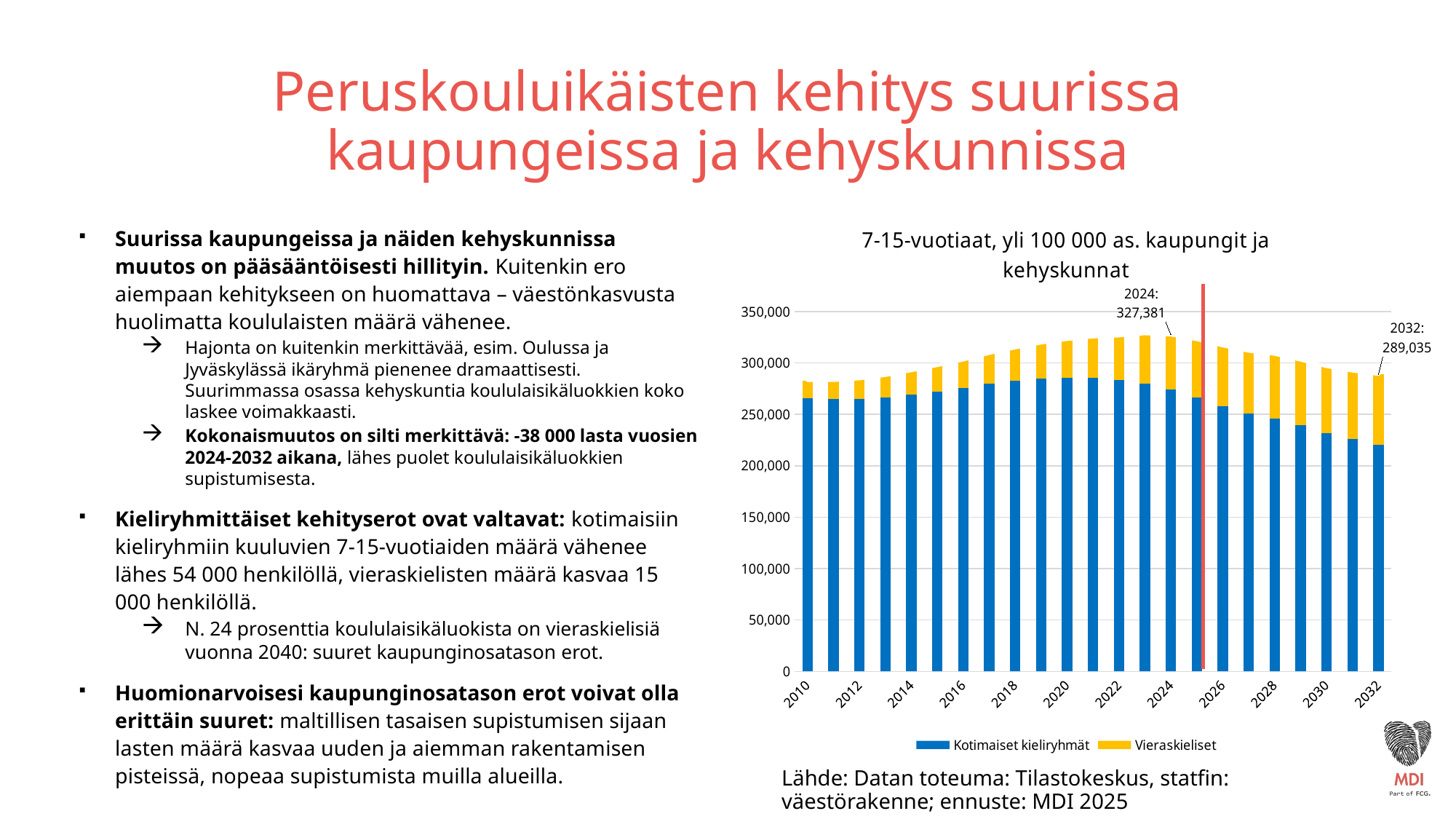
Is the value for Kotimaiset kieliryhmät in 2032 greater or less than 250,000? less What kind of chart is shown on the slide? Stacked bar chart Is the total for 2010 greater or less than 300,000? less What is the difference between the 2024 total and the 2032 total? 38,346 Do the total bar heights rise or fall from 2024 to 2032? fall What are the two series named in the legend? Kotimaiset kieliryhmät and Vieraskieliset Which year has the larger total, 2024 or 2032? 2024 In which year is the Kotimaiset kieliryhmät value lowest? 2032 How many years (bars) are plotted in the chart? 23 What is the total number of 7-15-year-olds shown for 2032? 289,035 How many series does the chart legend list? 2 What is the total number of 7-15-year-olds shown for 2024? 327,381